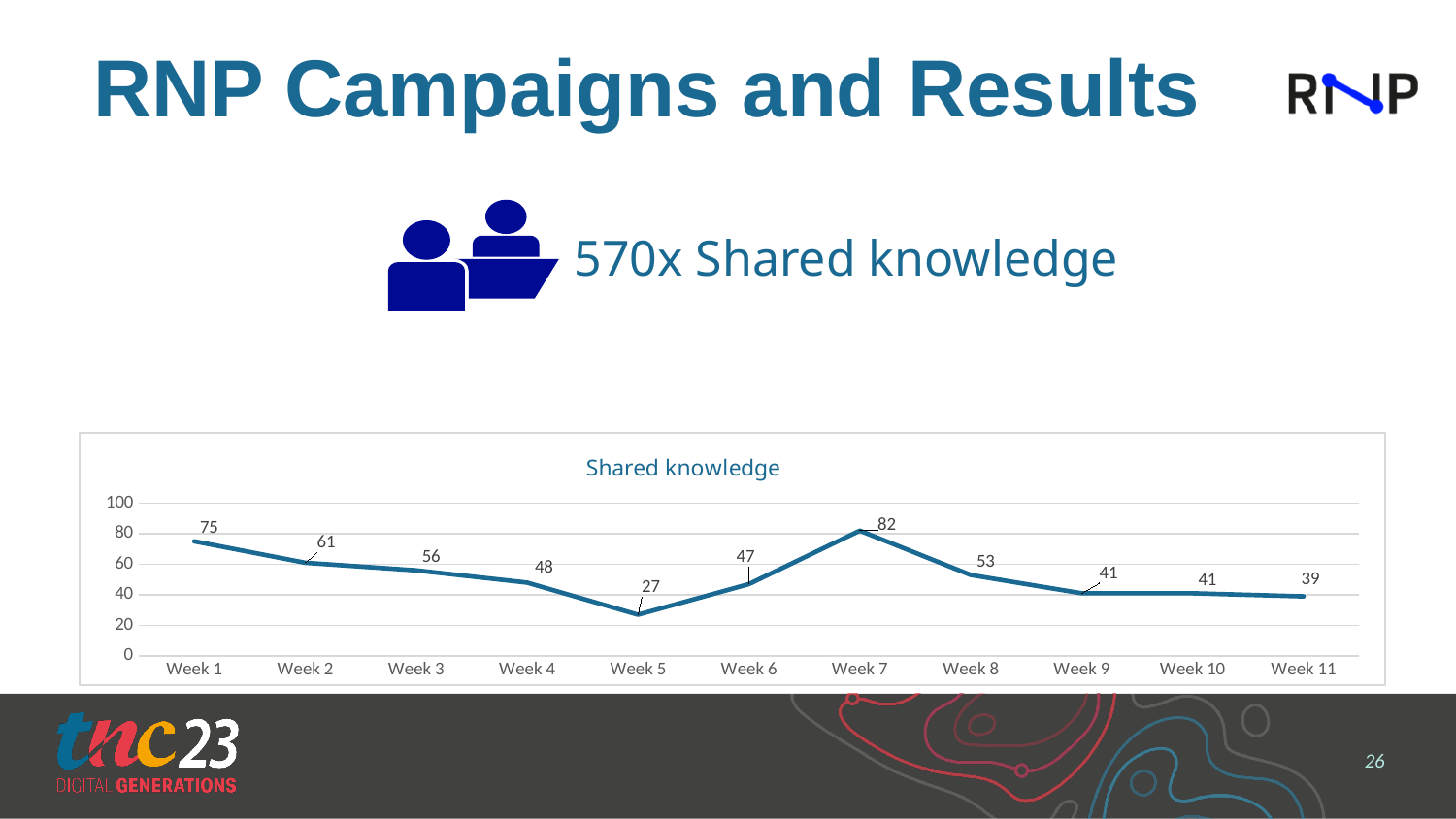
Is the value for Week 7 greater or less than 60? greater What is the value for Week 8 in the Shared knowledge chart? 53 What kind of chart is shown on the slide? Line chart How many weeks are plotted in the Shared knowledge chart? 11 What is the value for Week 5 in the Shared knowledge chart? 27 Which week has the lowest value in the Shared knowledge chart? Week 5 Which week has the highest value in the Shared knowledge chart? Week 7 What is the difference between the values for Week 1 and Week 2? 14 What is the title of the chart on the slide? Shared knowledge Which is larger, the value for Week 3 or the value for Week 6? Week 3 What is the difference between the values for Week 7 and Week 5? 55 What is the value for Week 1 in the Shared knowledge chart? 75